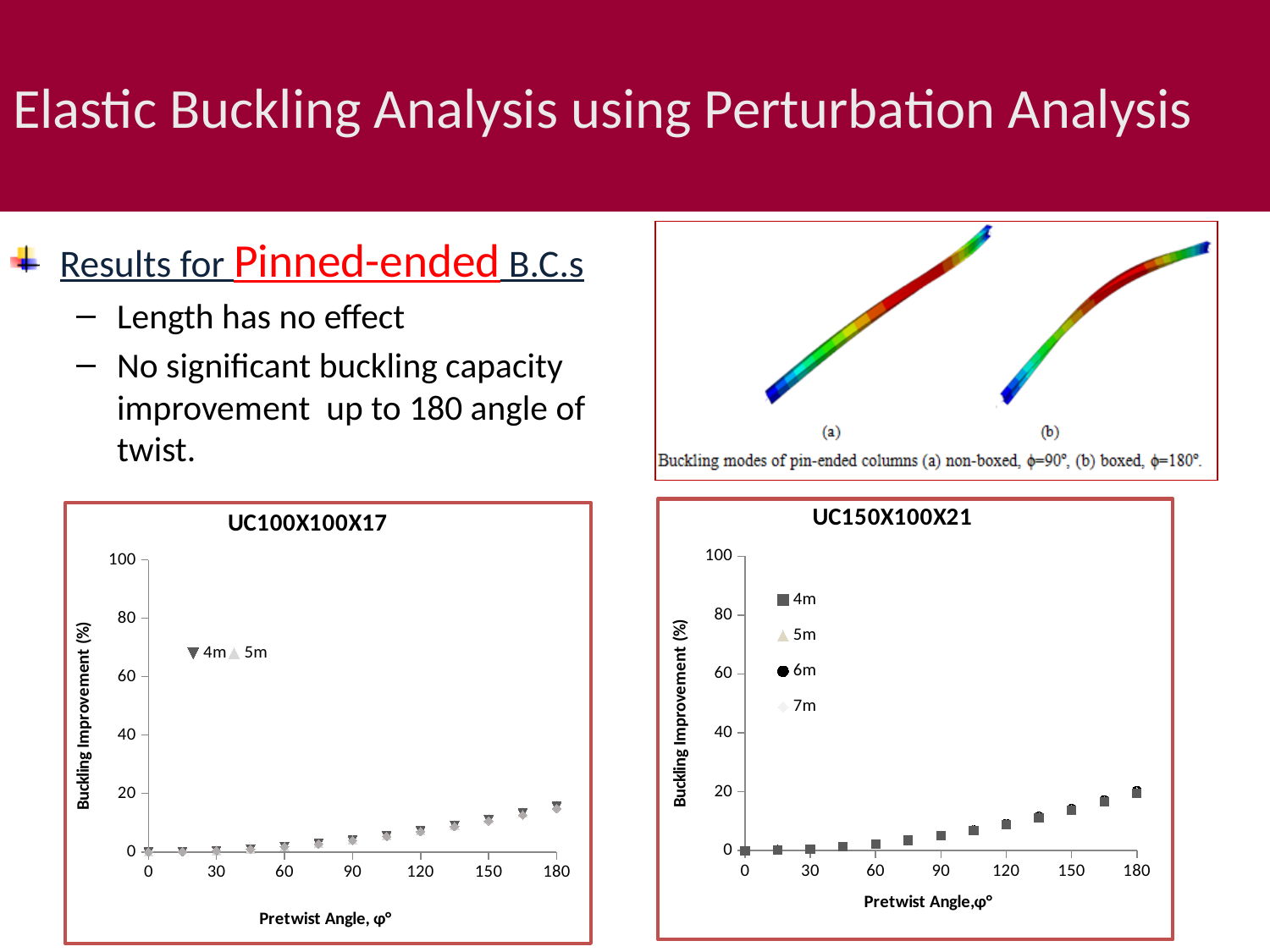
What kind of chart is the UC100X100X17 chart? scatter chart In the UC150X100X21 chart, is the value for the 6m series at a pretwist angle of 180 greater or less than 60? less How many series does the legend of the UC150X100X21 chart list? 4 What is the x-axis label of the UC150X100X21 chart? Pretwist Angle,φ° What is the highest value shown on the y axis of the UC150X100X21 chart? 100 In the UC100X100X17 chart, do the values rise or fall as the pretwist angle increases from 0 to 180? rise What is the y-axis label of the UC100X100X17 chart? Buckling Improvement (%) In the UC150X100X21 chart, is the value for the 4m series at a pretwist angle of 180 greater or less than 40? less In the UC100X100X17 chart, is the value for the 4m series at a pretwist angle of 90 greater or less than 20? less In the UC150X100X21 chart, do the values rise or fall as the pretwist angle increases from 0 to 180? rise How many series does the legend of the UC100X100X17 chart list? 2